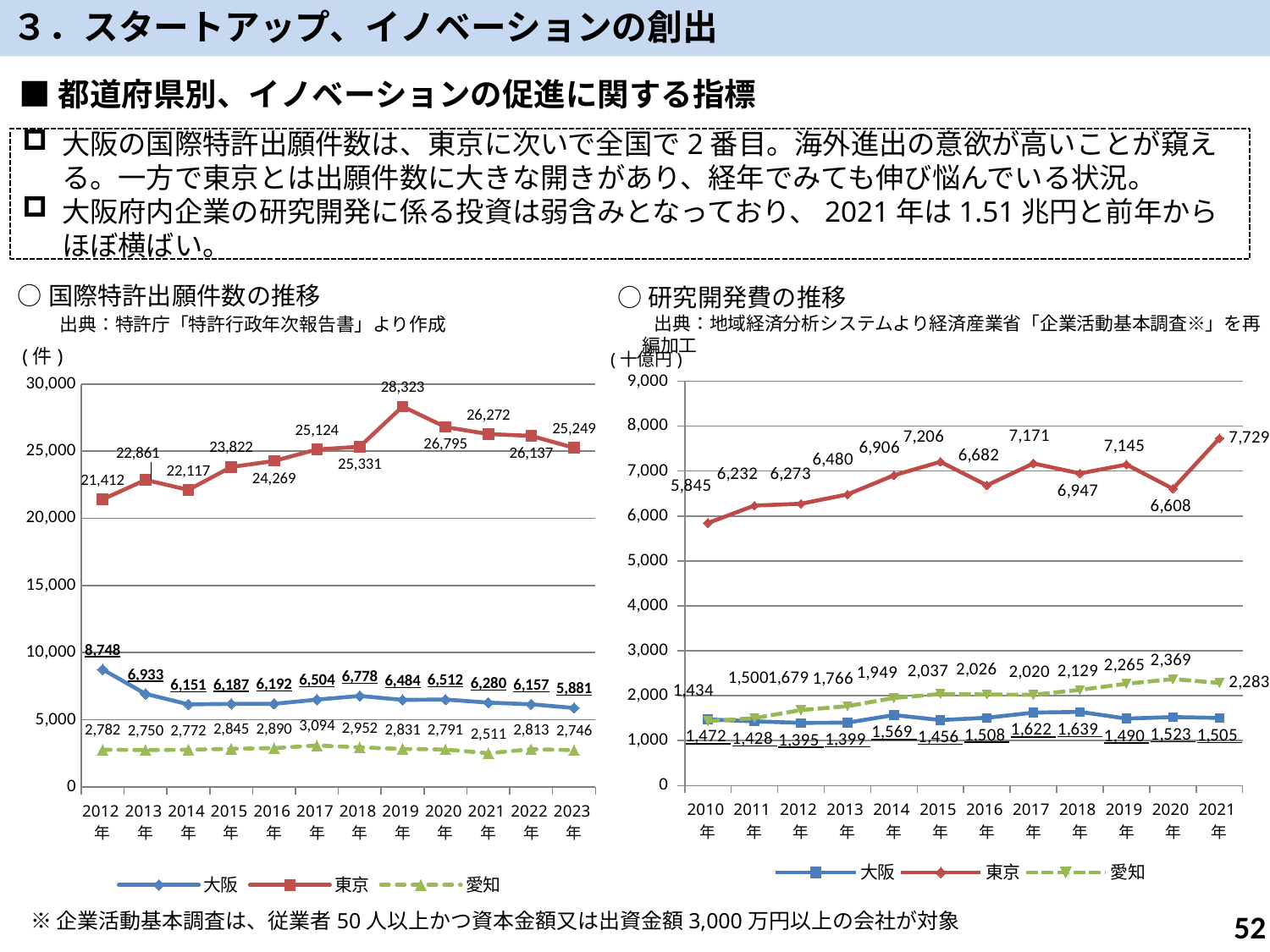
In the 研究開発費の推移 chart, in which year does 大阪 have its lowest value? 2012年 What type of chart is the 研究開発費の推移 chart? Line chart In the 研究開発費の推移 chart, what is the value for 大阪 in 2014年? 1,569 In the 国際特許出願件数の推移 chart, in which year does 愛知 reach its highest value? 2017年 In the 国際特許出願件数の推移 chart, what is the value for 東京 in 2019年? 28,323 In the 研究開発費の推移 chart, which is larger in 2020年, 愛知 or 大阪? 愛知 In the 国際特許出願件数の推移 chart, what is the value for 大阪 in 2023年? 5,881 In the 国際特許出願件数の推移 chart, what is the difference between 東京 and 大阪 in 2012年? 12,664 In the 国際特許出願件数の推移 chart, how many years are shown on the x axis? 12 In the 研究開発費の推移 chart, what is the value for 東京 in 2021年? 7,729 In the 国際特許出願件数の推移 chart, how many series does the legend list? 3 In the 研究開発費の推移 chart, what is the difference between 愛知 in 2020年 and 2021年? 86